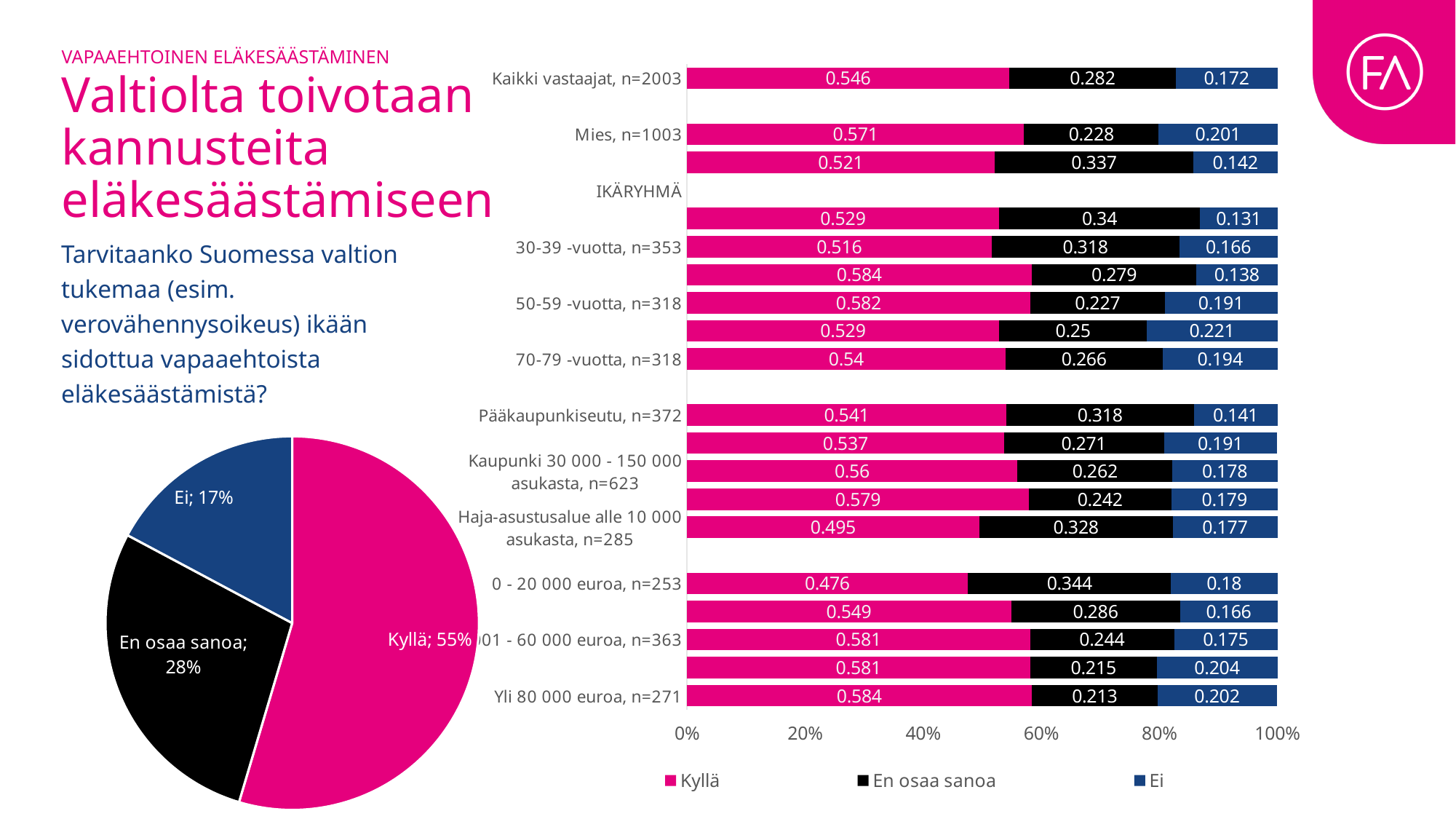
In the bar chart on the right, what is the "En osaa sanoa" value for "0 - 20 000 euroa, n=253"? 0.344 In the bar chart on the right, what is the "Kyllä" value for "50-59 -vuotta, n=318"? 0.582 In the pie chart on the left, which slice is the largest? Kyllä What kind of chart is the chart on the left of the slide? Pie chart What kind of chart is the chart on the right of the slide? Stacked bar chart How many series does the legend of the bar chart on the right list? 3 In the bar chart on the right, what is the "Kyllä" value for "Kaikki vastaajat, n=2003"? 0.546 In the pie chart on the left, what share of respondents answered "Kyllä"? 55% In the bar chart on the right, what is the difference between the "Kyllä" values for "Yli 80 000 euroa, n=271" and "0 - 20 000 euroa, n=253"? 0.108 In the pie chart on the left, which slice is the smallest? Ei In the bar chart on the right, what is the "Ei" value for "Mies, n=1003"? 0.201 In the bar chart on the right, which has the larger "Kyllä" value: "Pääkaupunkiseutu, n=372" or "Haja-asustusalue alle 10 000 asukasta, n=285"? Pääkaupunkiseutu, n=372